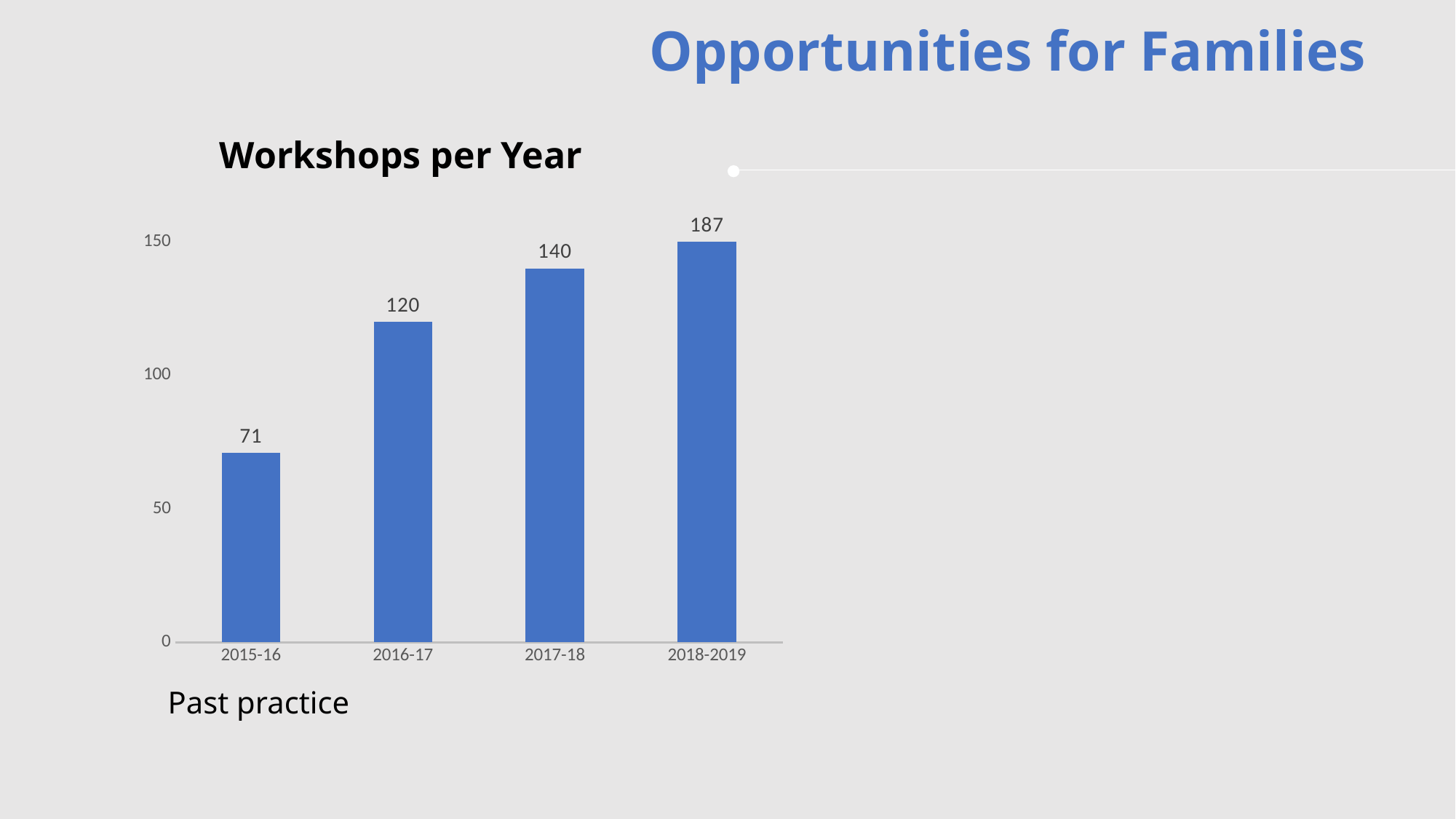
Do the values rise or fall from 2015-16 to 2018-2019? rise Which is larger, the value for 2016-17 or the value for 2017-18? 2017-18 What is the difference between the values for 2017-18 and 2016-17? 20 How many years are shown on the x axis of the chart? 4 What kind of chart is shown on the slide? bar chart What is the value for 2018-2019 in the Workshops per Year chart? 187 What is the value for 2017-18 in the Workshops per Year chart? 140 What is the difference between the values for 2018-2019 and 2015-16? 116 What is the value for 2015-16 in the Workshops per Year chart? 71 What is the value for 2016-17 in the Workshops per Year chart? 120 Which year has the highest number of workshops? 2018-2019 Which year has the lowest number of workshops? 2015-16